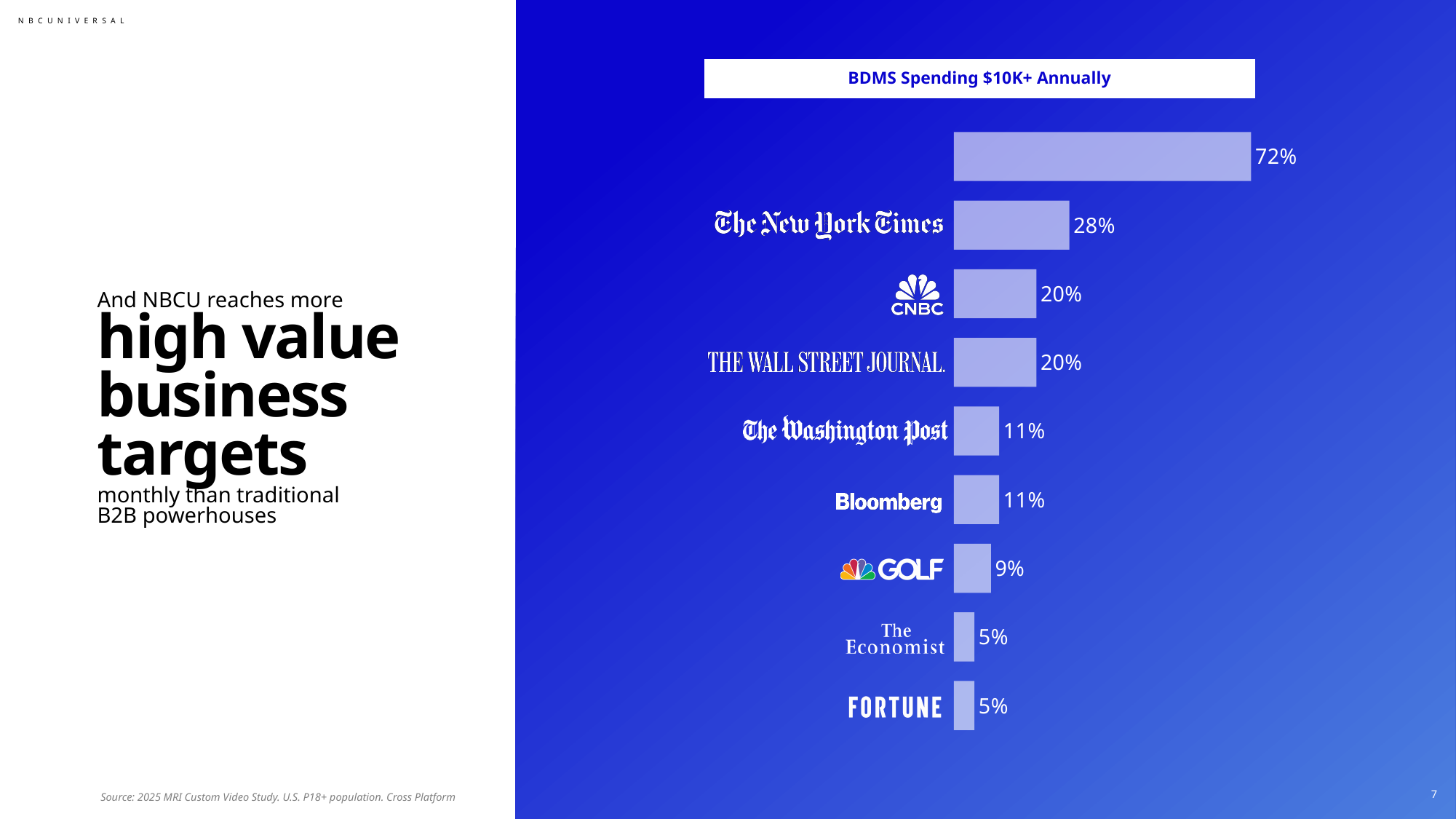
What is the value for Golf? 9% What is the difference between the values for The New York Times and The Washington Post? 17% Which has a larger value, CNBC or Bloomberg? CNBC How many bars are shown in the chart? 9 What is the value for Bloomberg? 11% What type of chart is shown on the slide? bar chart What is the value for The New York Times? 28% What is the value for CNBC? 20% What is the value for The Wall Street Journal? 20% What is the title of the chart? BDMS Spending $10K+ Annually What is the value for The Economist? 5% What is the highest value shown in the chart? 72%